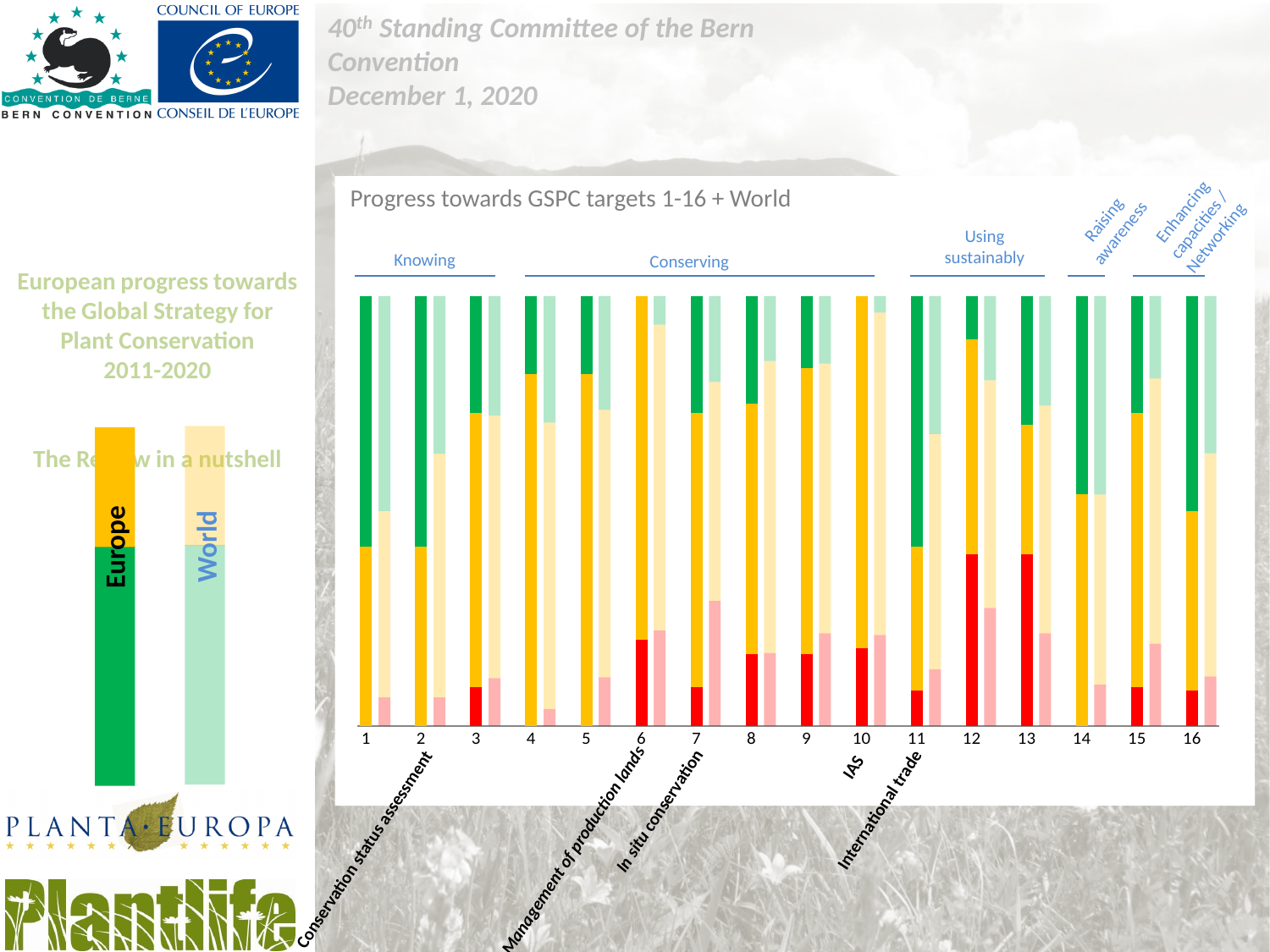
How many bars are plotted for each numbered target in the chart? 2 What kind of chart is shown on the slide? Stacked bar chart Which target is grouped under the heading 'Raising awareness'? 14 Is the red segment of the Europe bar larger for target 6 or for target 7? Target 6 Which targets are grouped under the heading 'Conserving'? 4 to 10 What is the title of the chart? Progress towards GSPC targets 1-16 + World Which targets are grouped under the heading 'Using sustainably'? 11, 12 and 13 Which targets are grouped under the heading 'Knowing'? 1, 2 and 3 Is the red segment of the Europe bar larger for target 12 or for target 11? Target 12 How many numbered targets are shown along the x axis of the chart? 16 Which two groups do the bars for each target represent, according to the key on the left of the slide? Europe and World Is the green segment of the Europe bar larger for target 1 or for target 3? Target 1